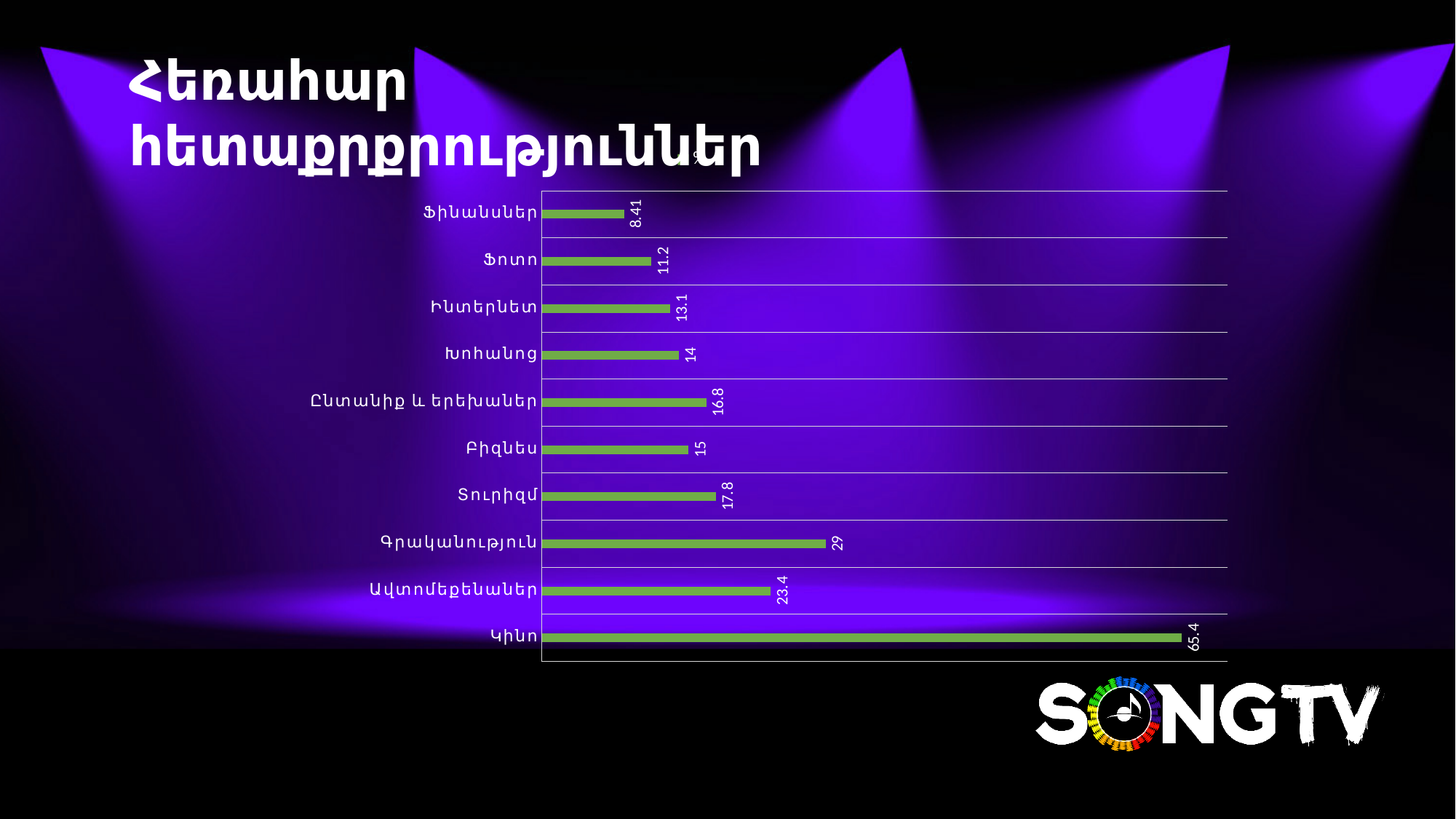
How many categories are shown in the chart? 10 Which category has the highest value? Կինո What is the difference between the values for Կինո and Գրականություն? 36.4 What colour are the bars in the chart? Green What is the value for Ընտանիք և երեխաներ? 16.8 What kind of chart is shown on the slide? Bar chart Which category has the lowest value? Ֆինանսներ What is the value for Ֆինանսներ? 8.41 What is the difference between the values for Ավտոմեքենաներ and Տուրիզմ? 5.6 What is the value for Կինո? 65.4 Which is larger, the value for Բիզնես or the value for Ընտանիք և երեխաներ? Ընտանիք և երեխաներ What is the value for Գրականություն? 29